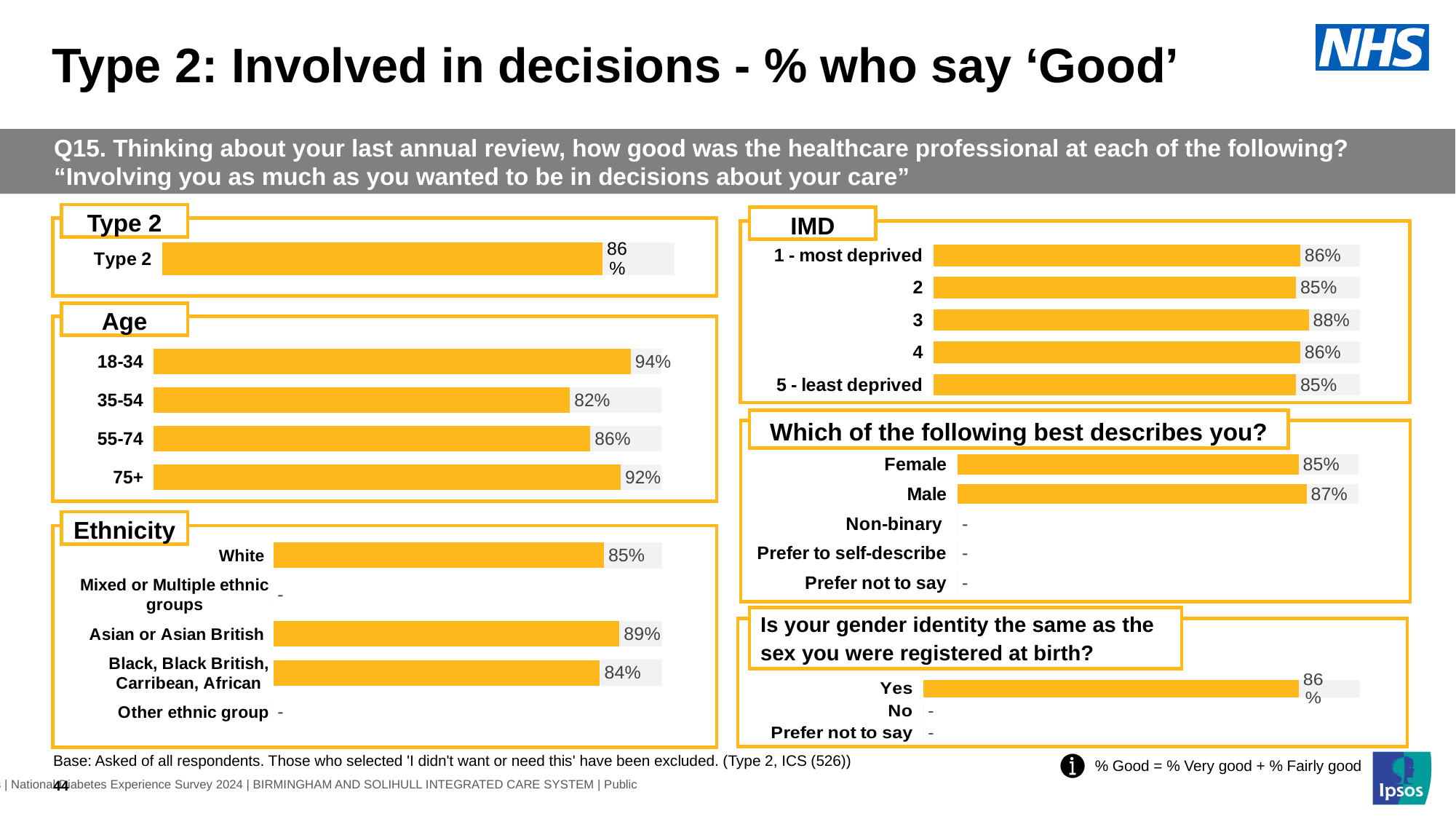
In the IMD chart, what is the value for 5 - least deprived? 85% In the 'Which of the following best describes you?' chart, what is the value for Male? 87% In the Age chart, what is the value for 18-34? 94% In the Ethnicity chart, what is the value for Asian or Asian British? 89% In the Age chart, which age group has the lowest value? 35-54 In the 'Which of the following best describes you?' chart, what is the difference between the values for Male and Female? 2 percentage points In the Ethnicity chart, which is larger, the value for White or the value for Black, Black British, Carribean, African? White What type of chart is used in the Age section? Bar chart In the IMD chart, which category has the highest value? 3 How many categories are shown in the IMD chart? 5 In the 'Is your gender identity the same as the sex you were registered at birth?' chart, what is the value for Yes? 86% In the Age chart, what is the difference between the values for 18-34 and 35-54? 12 percentage points